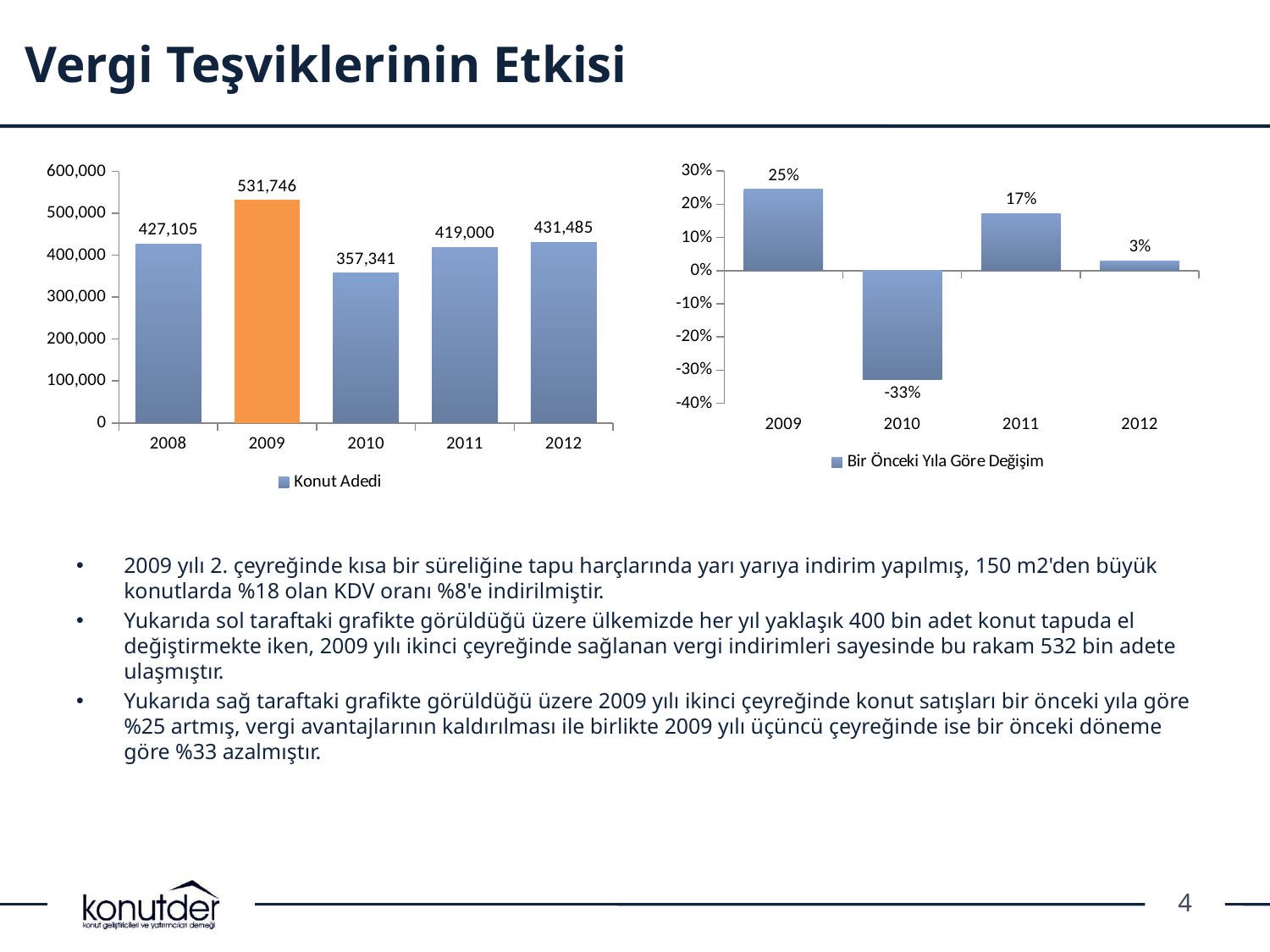
In the left chart (Konut Adedi), what is the value for 2009? 531,746 In the left chart (Konut Adedi), which year has the highest value? 2009 In the left chart (Konut Adedi), what is the difference between the 2009 and 2008 values? 104,641 In the left chart (Konut Adedi), which year has the lowest value? 2010 In the left chart (Konut Adedi), which bar is coloured orange? 2009 In the left chart (Konut Adedi), how many years are shown on the x axis? 5 What kind of chart is the right chart (Bir Önceki Yıla Göre Değişim)? bar chart In the right chart (Bir Önceki Yıla Göre Değişim), is the value for 2011 larger or smaller than the value for 2012? larger In the right chart (Bir Önceki Yıla Göre Değişim), which year has the highest value? 2009 In the right chart (Bir Önceki Yıla Göre Değişim), what is the value for 2012? 3% In the left chart (Konut Adedi), what is the value for 2010? 357,341 In the right chart (Bir Önceki Yıla Göre Değişim), what is the value for 2010? -33%